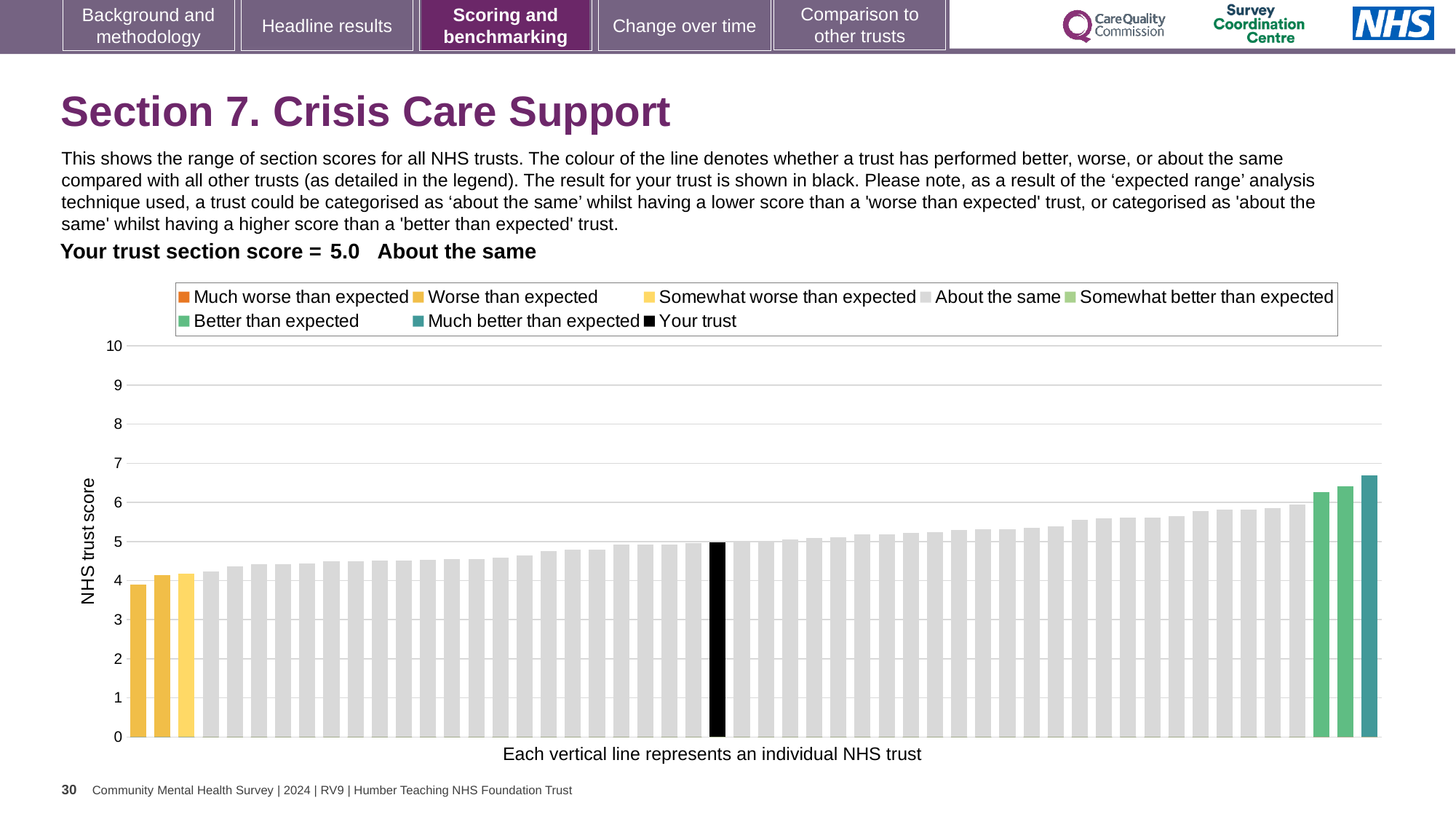
How many entries does the chart legend list? 8 Which legend category does the tallest bar belong to? Much better than expected Is the value of the shortest bar greater or less than 3? greater What kind of chart is shown on the slide? bar chart What does the caption below the chart say each vertical line represents? an individual NHS trust What is the section score for your trust shown on the slide? 5.0 Which category is your trust placed in for this section? About the same Is the value of the tallest bar greater or less than 6? greater How many bars are coloured as 'Much better than expected' (teal)? 1 What is the label on the vertical axis of the chart? NHS trust score Do the bar values rise or fall from left to right along the x axis? rise Which is larger: the score for your trust (black bar) or the tallest teal bar on the right? the tallest teal bar